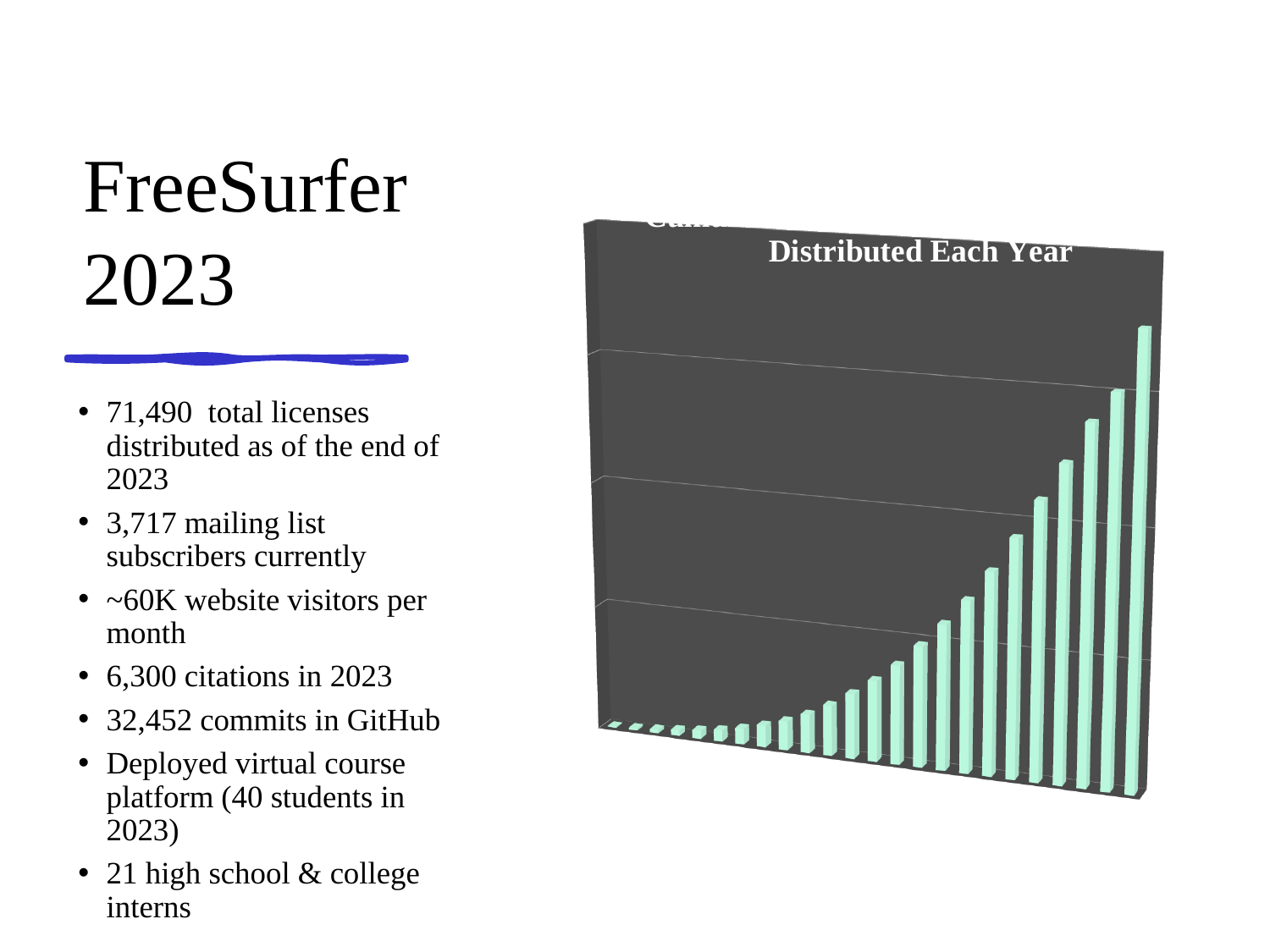
Which bar in the chart is the tallest, the leftmost or the rightmost? rightmost Which bar in the chart is the shortest, the leftmost or the rightmost? leftmost What kind of chart is shown on the slide? bar chart Is the rightmost bar larger or smaller than the bar immediately to its left? larger Do the bar values rise or fall from left to right across the chart? rise What are the last three words of the chart title? Distributed Each Year What colour are the bars in the chart? light green